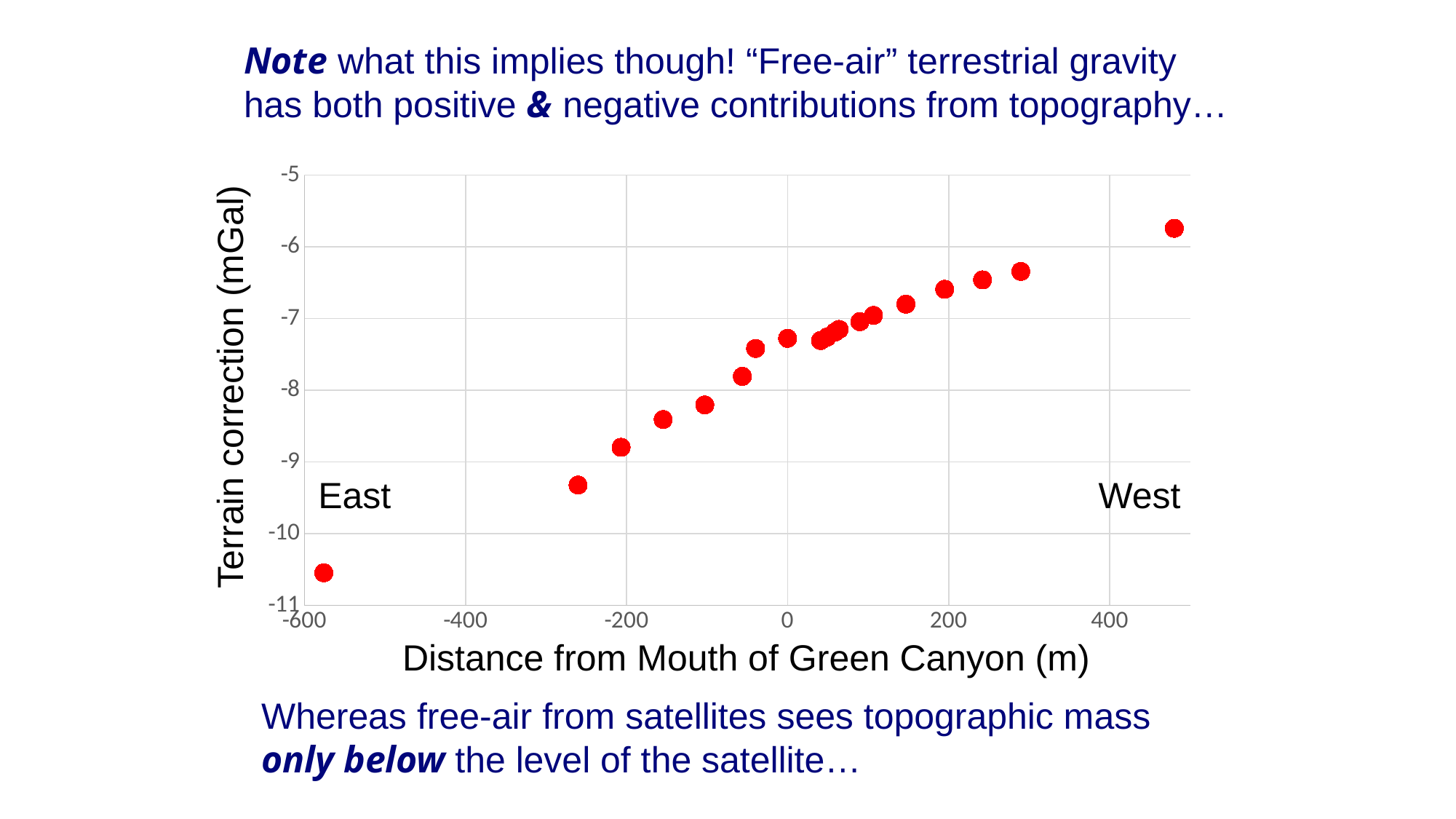
Which point has the highest terrain correction, the easternmost or the westernmost? westernmost What is the label of the x axis? Distance from Mouth of Green Canyon (m) What is the label of the y axis? Terrain correction (mGal) Is the terrain correction for the point near -200 m greater or less than -8 mGal? less Which has the larger terrain correction: the point near 200 m or the point near -200 m? the point near 200 m Is the terrain correction at a distance of 0 m greater or less than -8 mGal? greater What kind of chart is shown on the slide? scatter plot Is the terrain correction for the easternmost (leftmost) point greater or less than -10 mGal? less Which point has the lowest terrain correction, the easternmost or the westernmost? easternmost Do the terrain correction values rise or fall as distance from the mouth of Green Canyon increases from east to west? rise